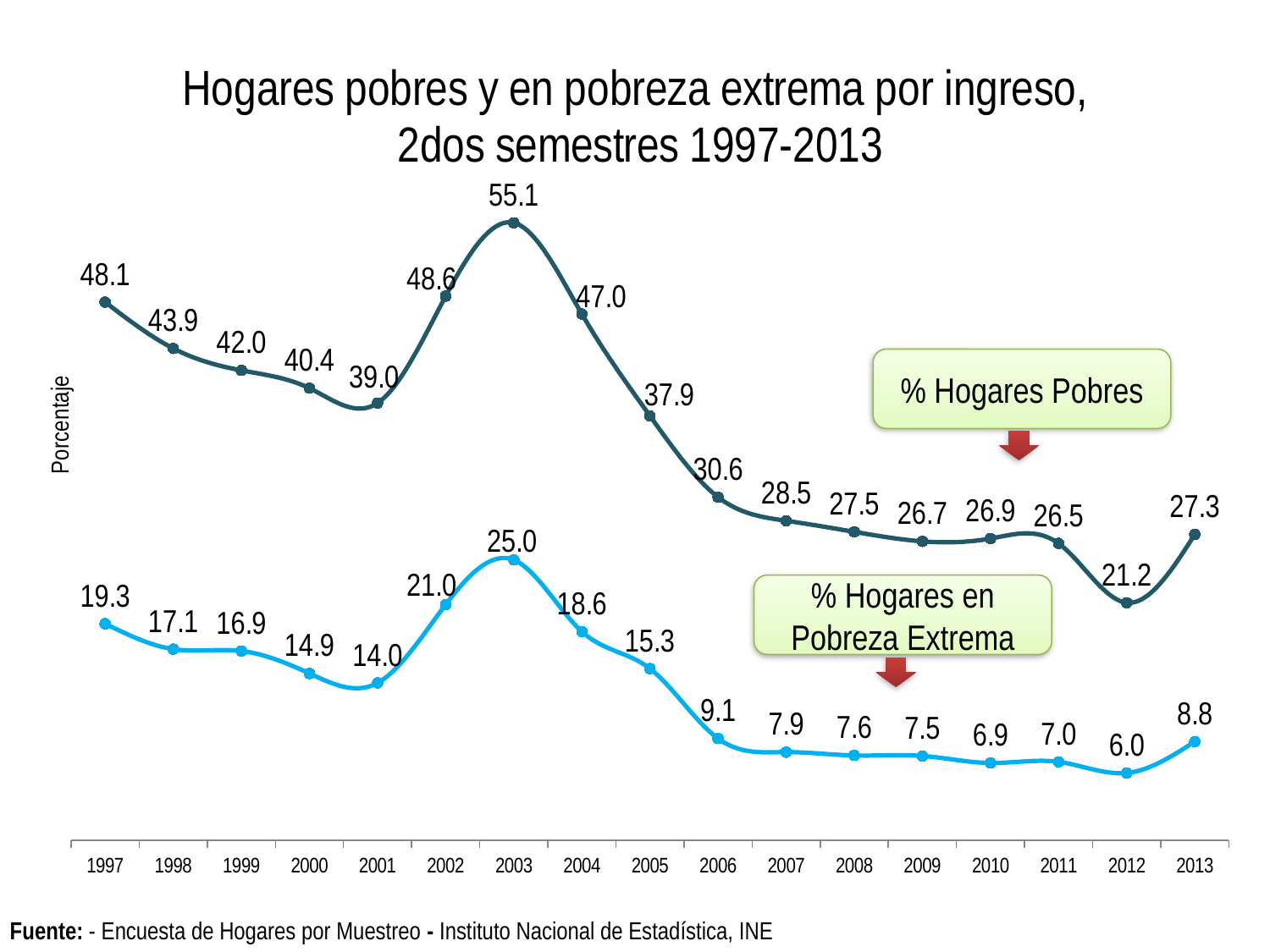
How many years are shown on the x axis? 17 How many series are plotted on the chart? 2 What is the value for % Hogares en Pobreza Extrema in 2012? 6.0 What kind of chart is shown on the slide? Line chart In which year is % Hogares en Pobreza Extrema lowest? 2012 What is the difference between % Hogares Pobres and % Hogares en Pobreza Extrema in 1997? 28.8 What is the value for % Hogares Pobres in 2003? 55.1 Which is larger for % Hogares Pobres: the value in 2002 or the value in 2004? 2002 What is the title of the chart? Hogares pobres y en pobreza extrema por ingreso, 2dos semestres 1997-2013 Between 2003 and 2009, does % Hogares Pobres rise or fall? Fall What is the value for % Hogares en Pobreza Extrema in 2013? 8.8 In which year is % Hogares Pobres highest? 2003